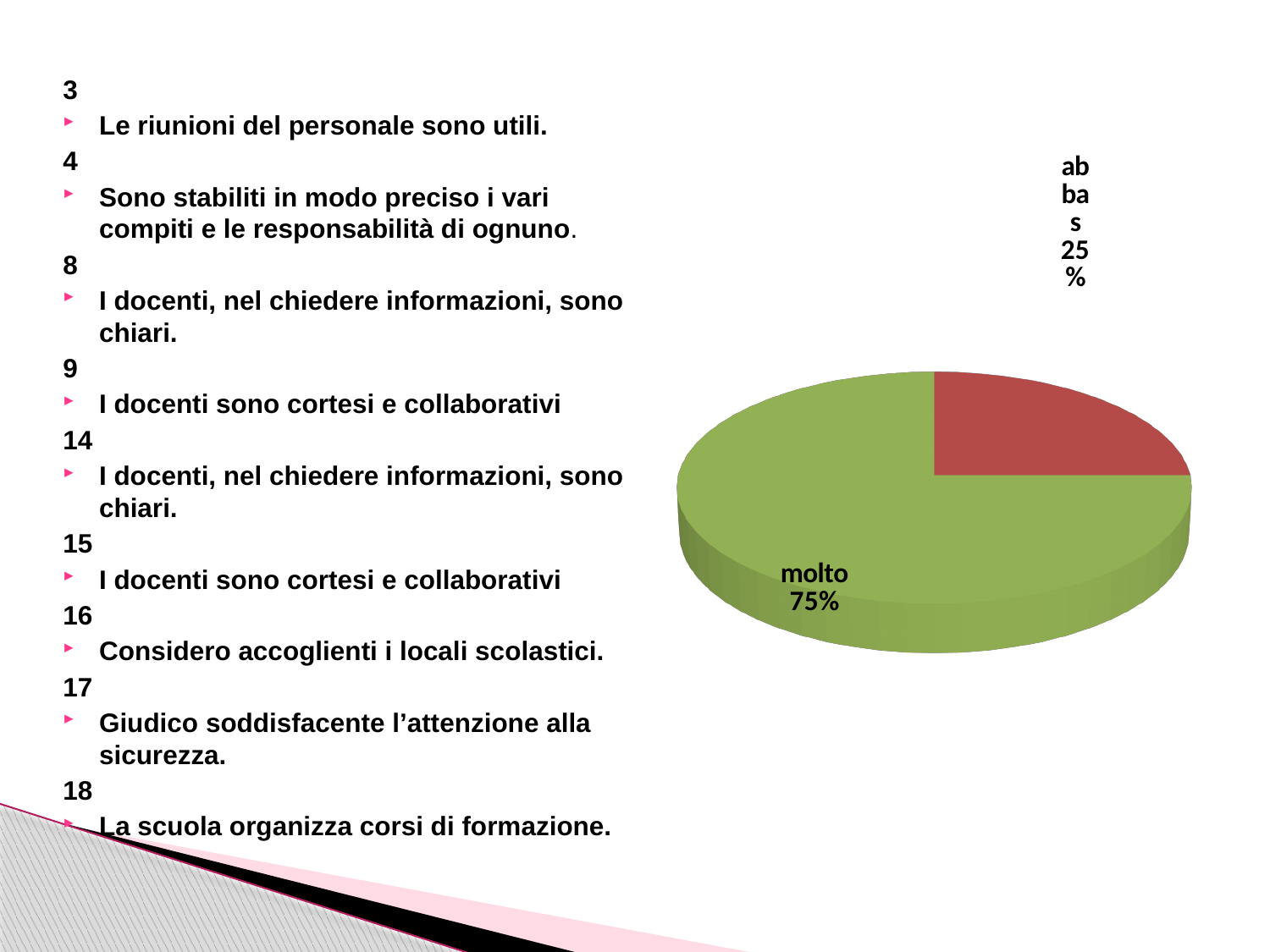
What colour is the "molto" slice of the pie chart? green What percentage is shown for the "molto" slice of the pie chart? 75% What percentage is shown for the "abbas" slice of the pie chart? 25% What do the two slice percentages in the pie chart add up to? 100% What kind of chart is shown on the slide? pie chart Which slice of the pie chart is the smallest? abbas Which slice of the pie chart is the largest? molto What share of the pie does the "molto" slice represent? 75% What is the difference in percentage points between the "molto" and "abbas" slices? 50 How many slices does the pie chart have? 2 Which is larger in the pie chart, "molto" or "abbas"? molto What colour is the "abbas" slice of the pie chart? red